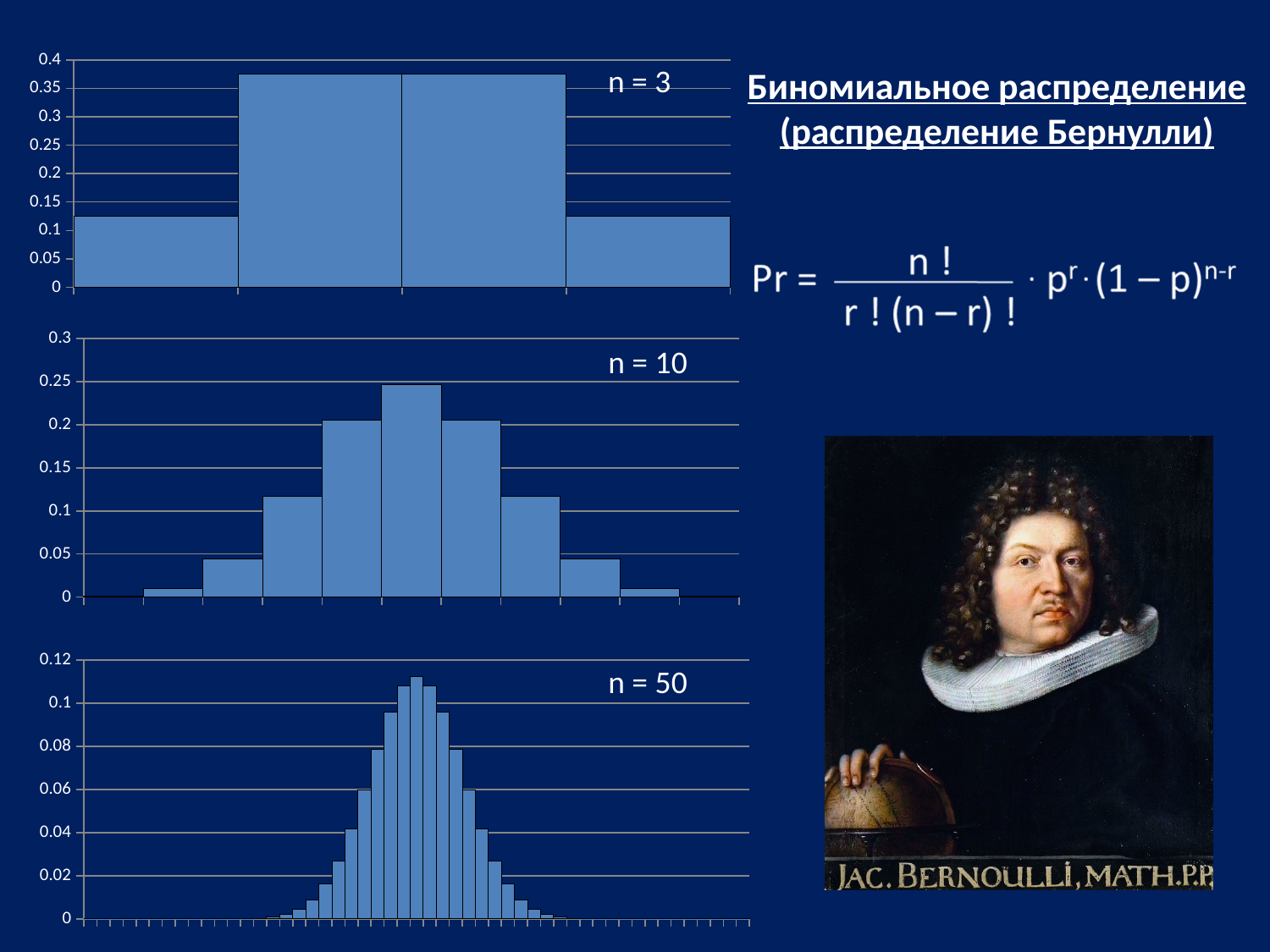
In the chart labelled n = 3, which is larger: the leftmost bar or the second bar from the left? the second bar from the left In the chart labelled n = 3, is the value of the tallest bars greater or less than 0.35? greater What kind of chart is the chart labelled n = 3? bar chart In the chart labelled n = 3, is the value of the leftmost bar greater or less than 0.1? greater In the chart labelled n = 10, is the value of the tallest bar greater or less than 0.2? greater In the chart labelled n = 10, where is the tallest bar located? in the middle What is the highest value shown on the vertical axis of the chart labelled n = 50? 0.12 How many charts are shown on the slide? 3 How many bars are shown in the chart labelled n = 3? 4